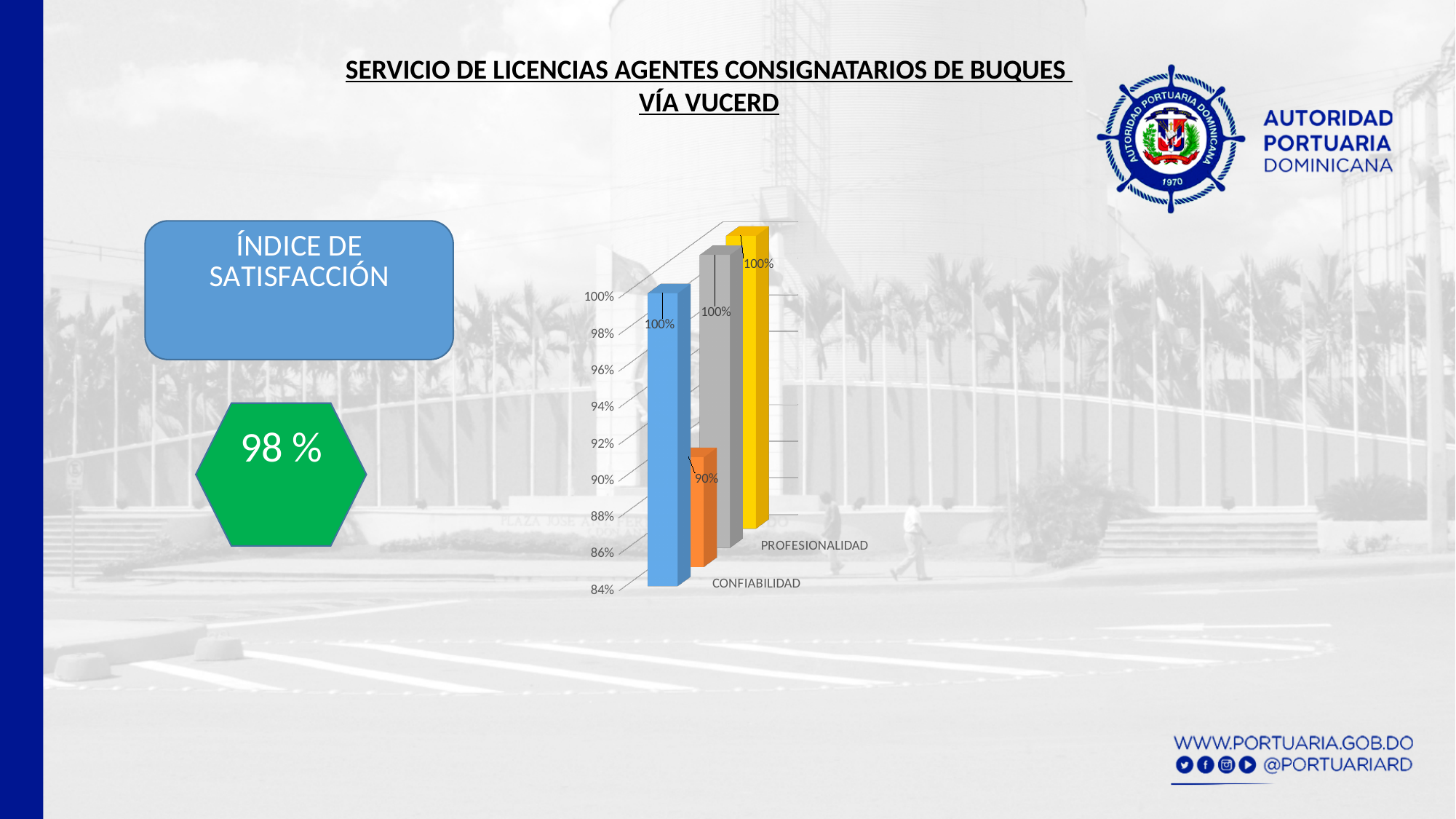
What is the difference between the highest labelled value and the lowest labelled value in the chart? 10 percentage points What value is labelled on the orange bar? 90% What kind of chart is shown on the slide? Bar chart Is the value of the orange bar greater or less than 92%? less Which bar is larger, the blue bar or the orange bar? The blue bar What value is labelled on the yellow bar? 100% What value is labelled on the blue bar? 100% What is the lowest value shown by a data label in the chart? 90% How many bars are labelled 100%? 3 What is the highest value shown by a data label in the chart? 100% How many bars are plotted in the chart? 4 What is the lowest tick value shown on the vertical axis of the chart? 84%